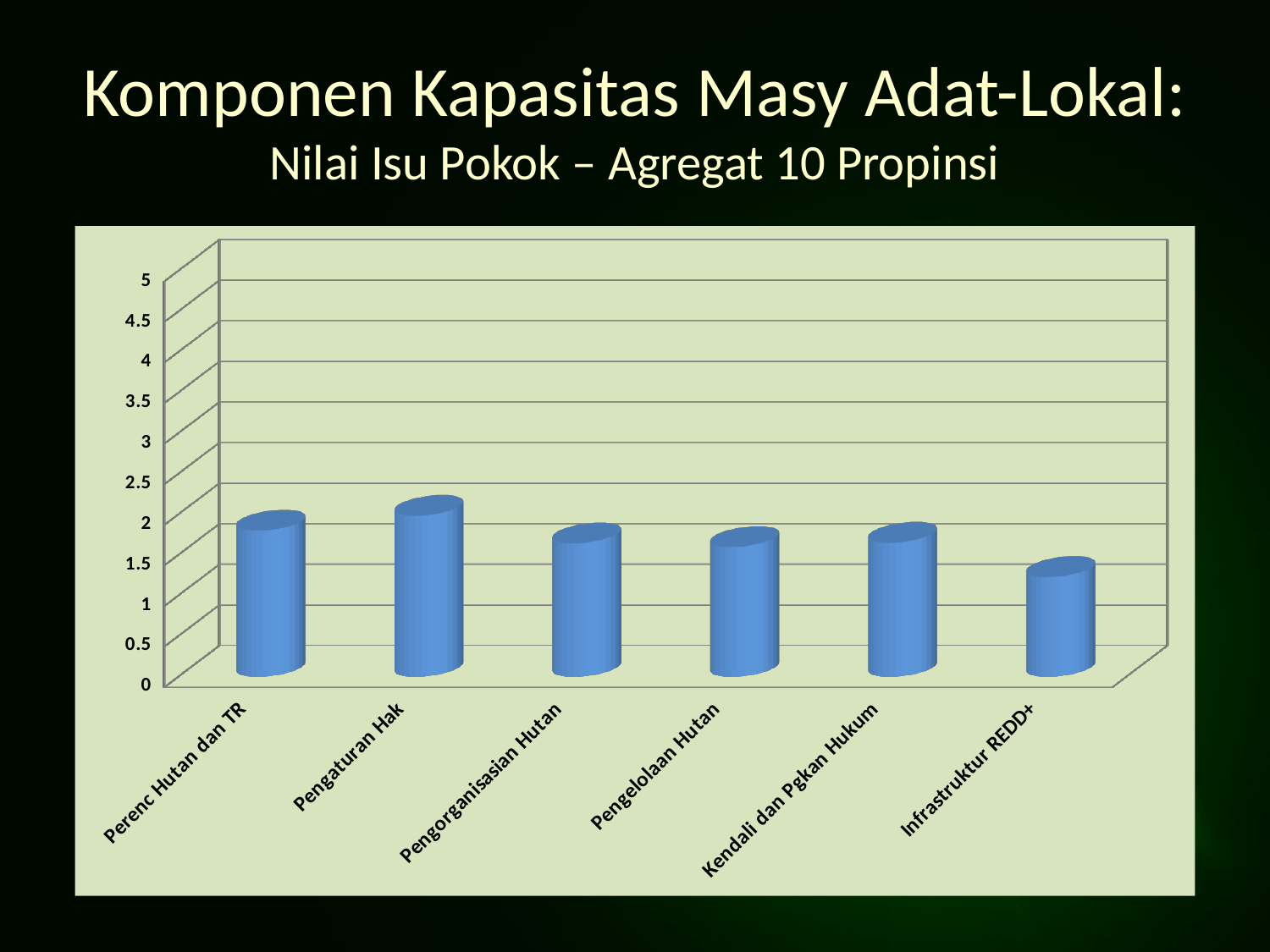
Is the value for Pengelolaan Hutan greater or less than 2? less What kind of chart is shown on the slide? bar chart What is the subtitle of the slide above the chart? Nilai Isu Pokok – Agregat 10 Propinsi Which is larger, the value for Pengaturan Hak or the value for Pengelolaan Hutan? Pengaturan Hak Which category has the lowest value? Infrastruktur REDD+ Is the value for Perenc Hutan dan TR greater or less than 1.5? greater Which is larger, the value for Perenc Hutan dan TR or the value for Infrastruktur REDD+? Perenc Hutan dan TR Is the value for Kendali dan Pgkan Hukum greater or less than 1? greater What is the maximum value shown on the vertical axis? 5 How many categories are plotted on the chart? 6 Which category has the highest value? Pengaturan Hak